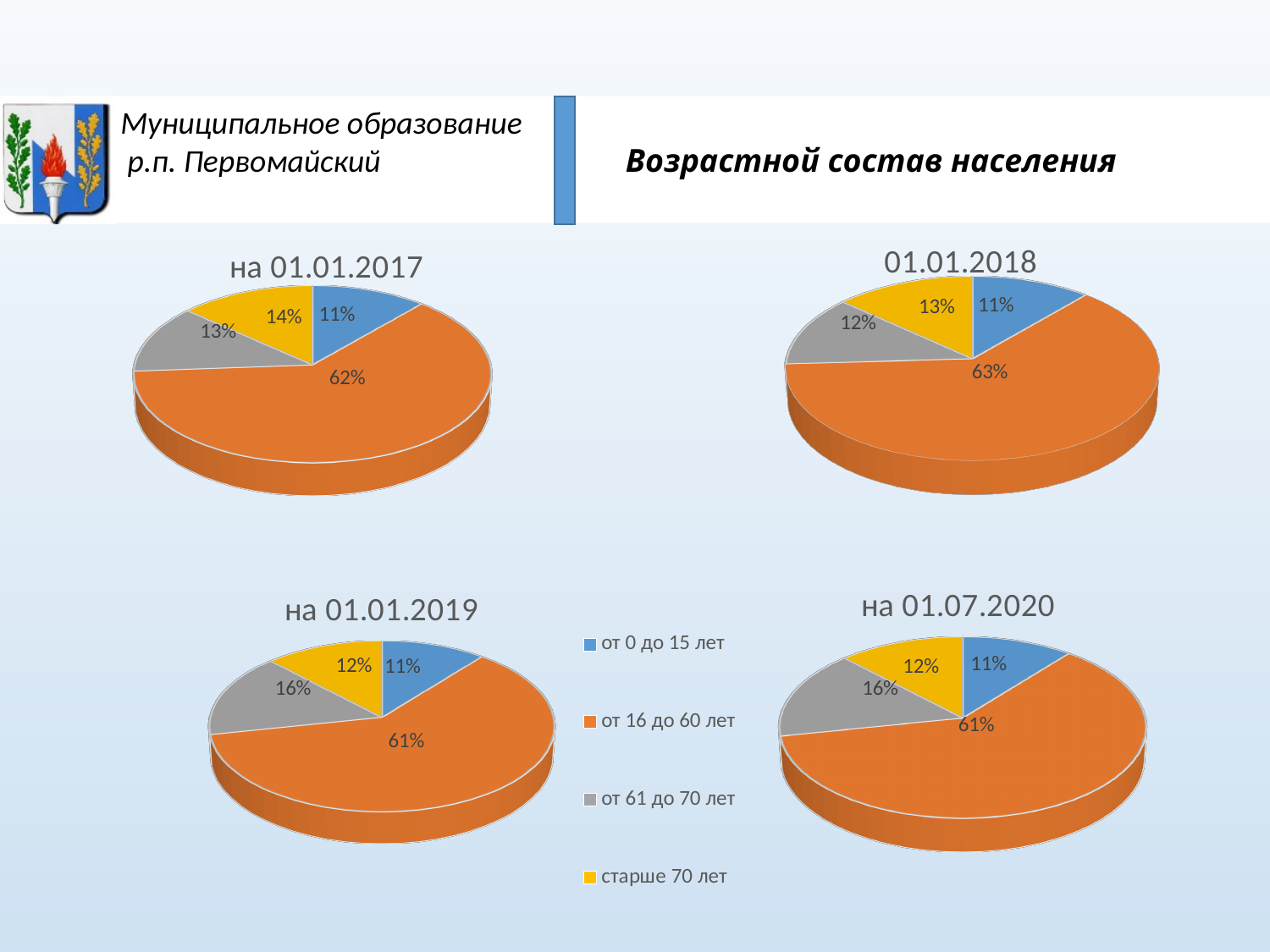
In the chart titled "на 01.01.2019", what share does the "старше 70 лет" slice have? 12% In the chart titled "на 01.01.2017", which category has the largest slice? от 16 до 60 лет In the chart titled "на 01.01.2017", what share does the "от 16 до 60 лет" slice have? 62% In the chart titled "на 01.01.2019", what is the difference between the "от 61 до 70 лет" share and the "старше 70 лет" share? 4% In the chart titled "01.01.2018", which category has the smallest slice? от 0 до 15 лет In the chart titled "01.01.2018", what share does the "от 61 до 70 лет" slice have? 12% How many slices does the chart titled "на 01.07.2020" have? 4 In the chart titled "на 01.01.2017", which is larger: the "старше 70 лет" slice or the "от 61 до 70 лет" slice? старше 70 лет Which colour represents "от 61 до 70 лет" in the legend? Gray In the chart titled "на 01.07.2020", what share does the "от 0 до 15 лет" slice have? 11% How many entries does the legend on the slide list? 4 What kind of chart is the chart titled "01.01.2018"? Pie chart